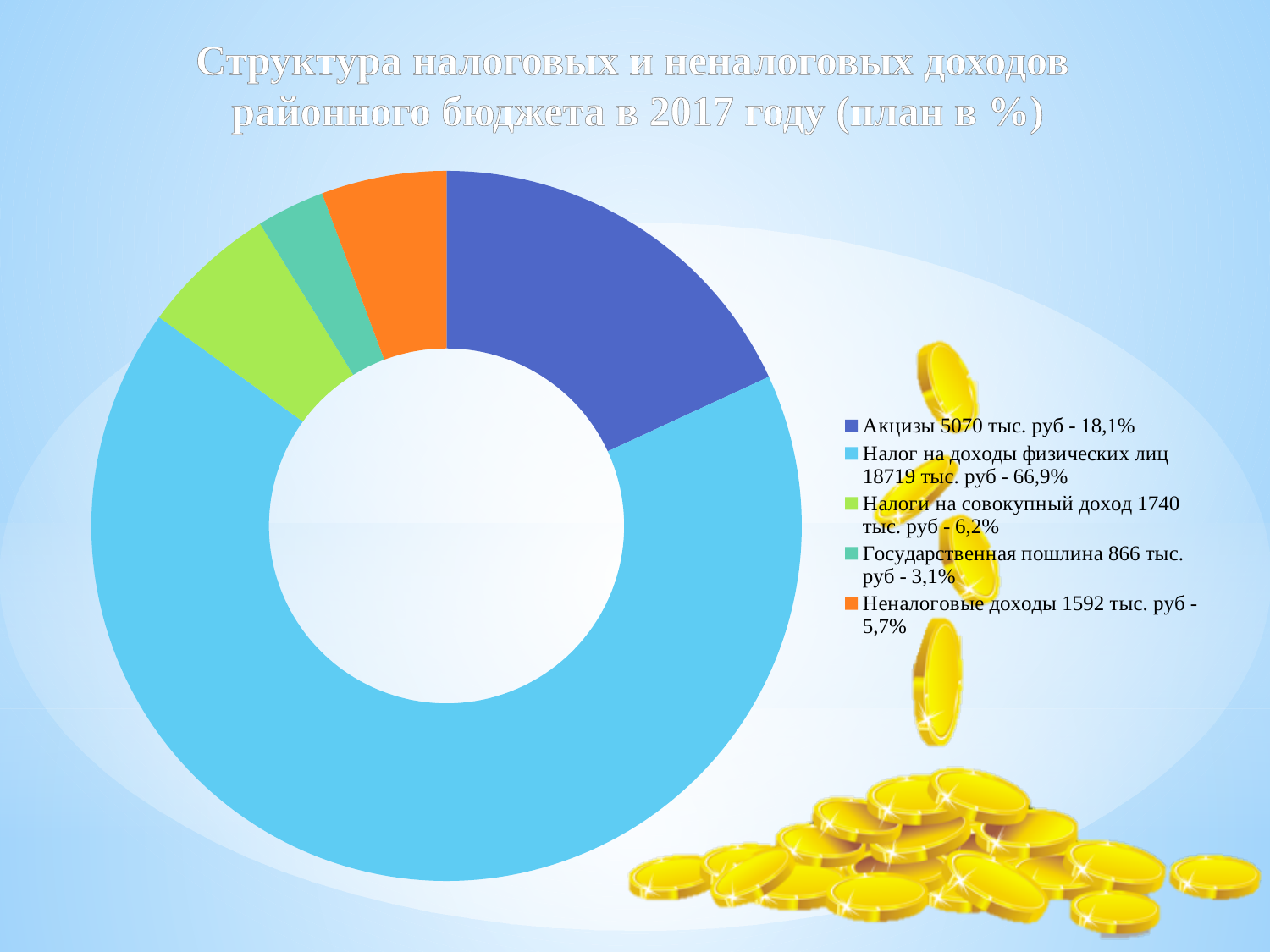
Which category has the largest share of the chart? Налог на доходы физических лиц What is the difference in percentage points between Акцизы and Налоги на совокупный доход? 11,9 What is the value in тыс. руб for Акцизы? 5070 тыс. руб What percentage is shown for Неналоговые доходы? 5,7% Which is larger: Налоги на совокупный доход or Неналоговые доходы? Налоги на совокупный доход Which category has the smallest share of the chart? Государственная пошлина What year does the chart title refer to? 2017 How many categories does the chart show? 5 What share of the chart does Налог на доходы физических лиц represent? 66,9% What kind of chart is shown on the slide? Doughnut chart What is the value in тыс. руб for Государственная пошлина? 866 тыс. руб What is the difference in тыс. руб between Неналоговые доходы and Государственная пошлина? 726 тыс. руб